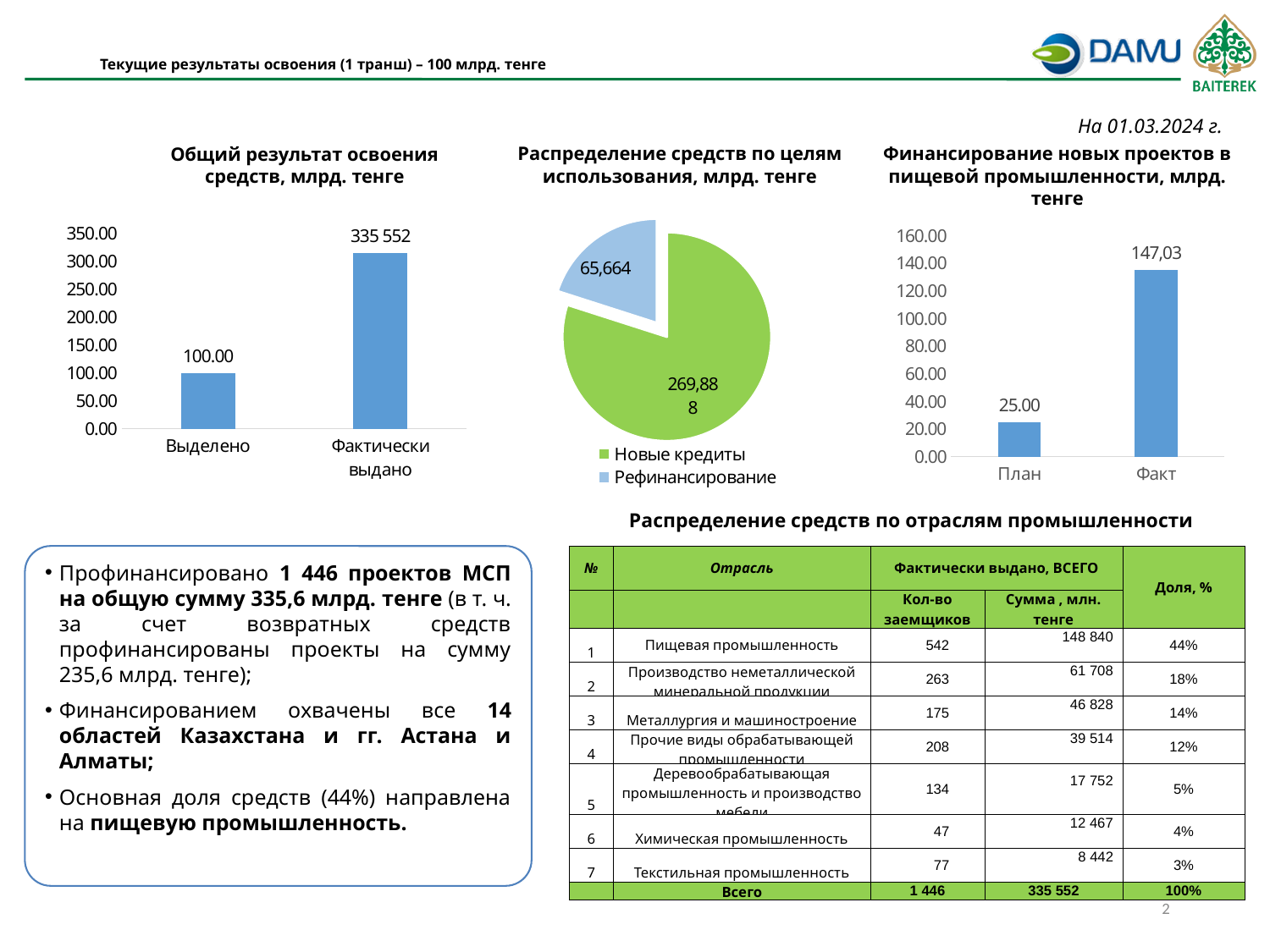
In the pie chart 'Распределение средств по целям использования, млрд. тенге', which slice is larger? Новые кредиты In the chart 'Финансирование новых проектов в пищевой промышленности, млрд. тенге', what is the value for 'Факт'? 147,03 In the chart 'Общий результат освоения средств, млрд. тенге', what is the value for 'Выделено'? 100.00 In the pie chart 'Распределение средств по целям использования, млрд. тенге', what is the value for 'Рефинансирование'? 65,664 How many categories are shown on the x axis of the chart 'Финансирование новых проектов в пищевой промышленности, млрд. тенге'? 2 In the chart 'Общий результат освоения средств, млрд. тенге', what is the value for 'Фактически выдано'? 335 552 In the pie chart 'Распределение средств по целям использования, млрд. тенге', what is the value for 'Новые кредиты'? 269,888 What kind of chart is 'Общий результат освоения средств, млрд. тенге'? bar chart How many entries does the legend of the pie chart 'Распределение средств по целям использования, млрд. тенге' list? 2 In the chart 'Общий результат освоения средств, млрд. тенге', which category has the higher value? Фактически выдано In the chart 'Финансирование новых проектов в пищевой промышленности, млрд. тенге', what is the value for 'План'? 25.00